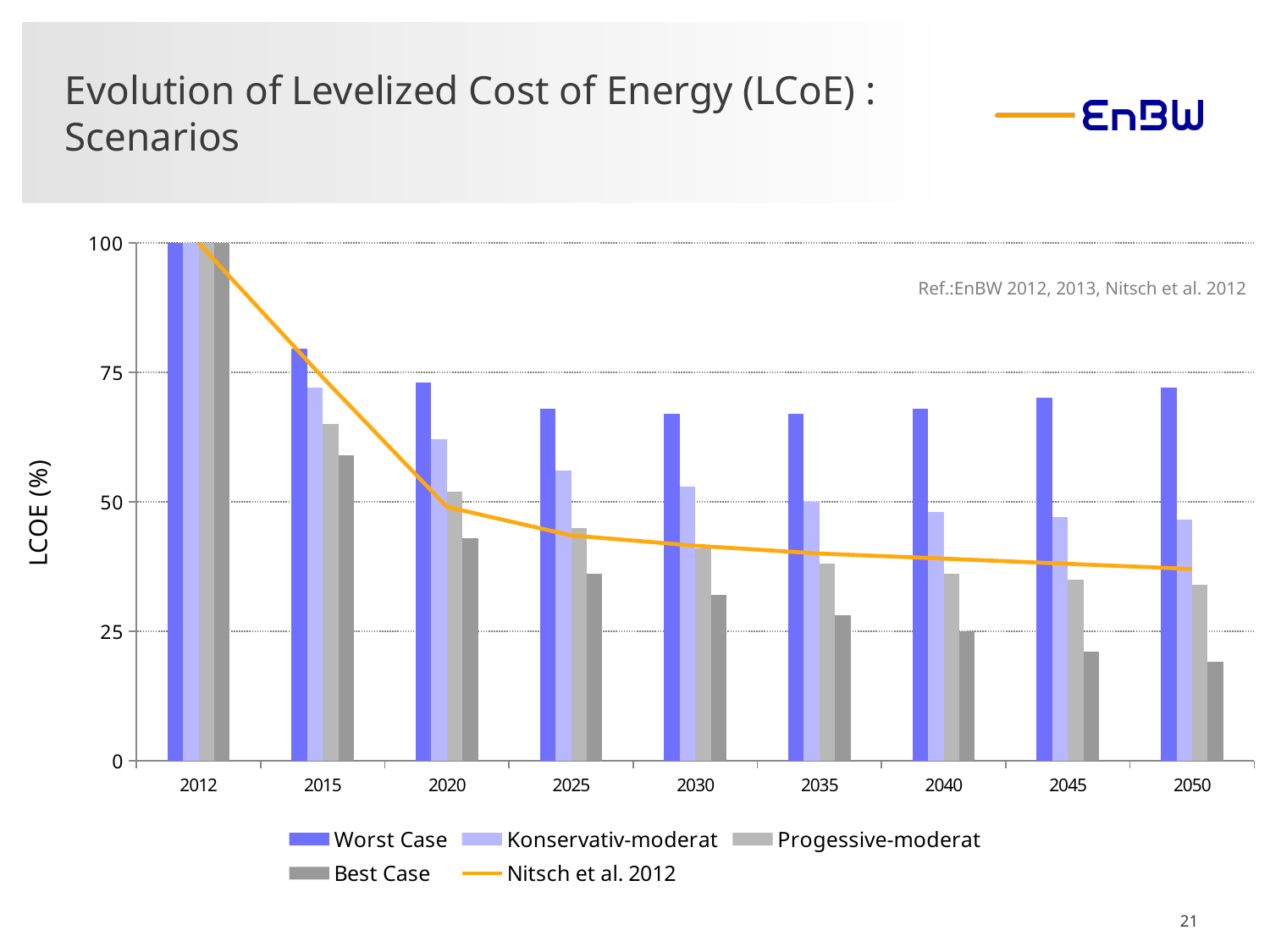
How many years are shown on the x axis? 9 Is the Worst Case value for 2025 greater or less than 75? less What kind of chart is this? Bar chart with a line series How many series does the legend list? 5 Is the Konservativ-moderat value for 2020 greater or less than 50? greater In 2050, which is larger: Worst Case or Best Case? Worst Case What is the label on the y axis? LCOE (%) In 2020, which is larger: Konservativ-moderat or Progessive-moderat? Konservativ-moderat Do the Best Case values rise or fall from 2012 to 2050? fall Is the Best Case value for 2050 greater or less than 25? less What is the Worst Case value in 2012? 100